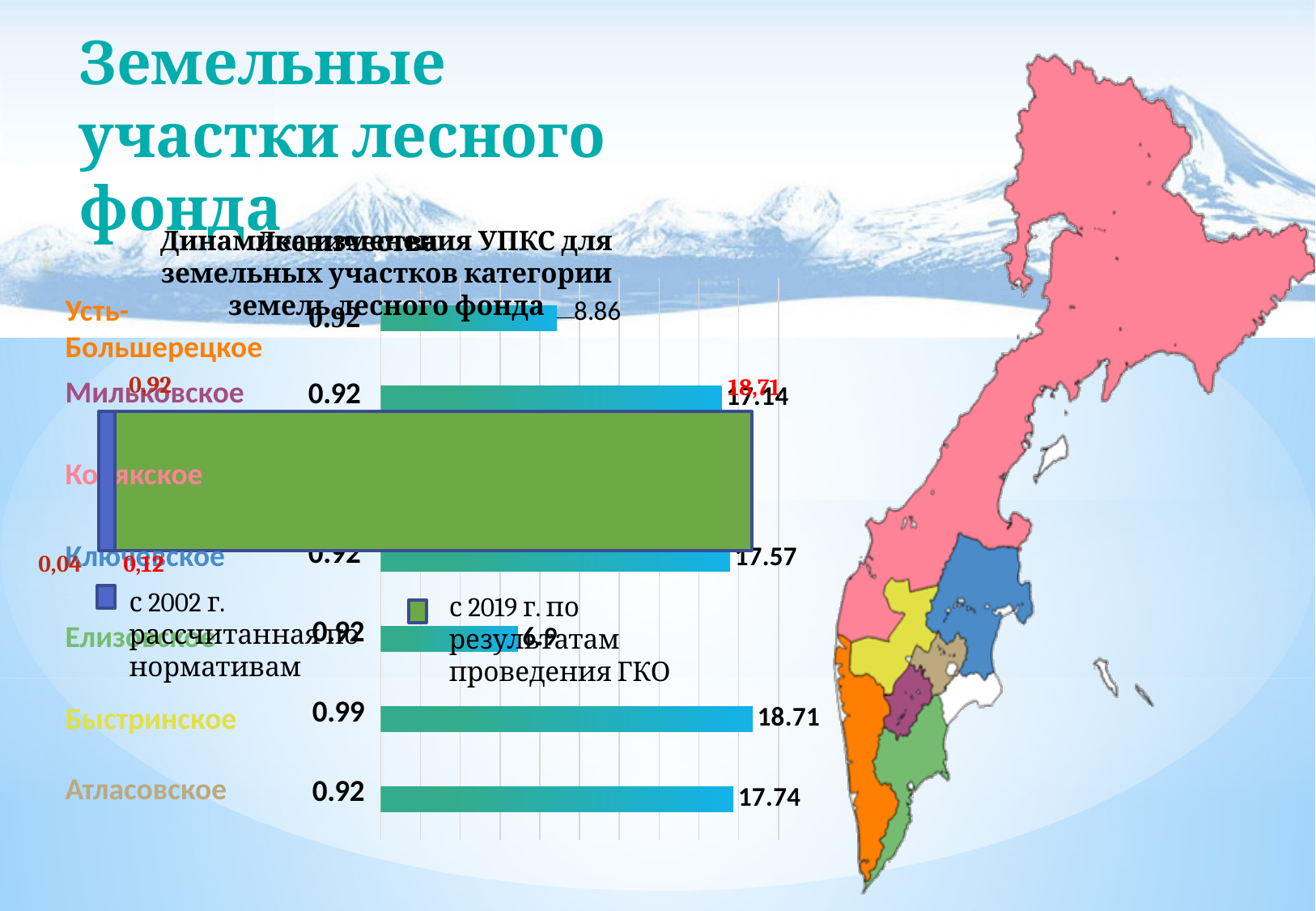
Among the districts with a labelled 2019 value, which has the highest value in the 'с 2019 г.' series? Быстринское Among the districts with a labelled 2019 value, which has the lowest value in the 'с 2019 г.' series? Елизовское How much larger is the 2019 value for Быстринское than the 2019 value for Атласовское? 0.97 What is the value for Атласовское in the 'с 2019 г. по результатам проведения ГКО' series? 17.74 What is the value for Елизовское in the 'с 2019 г. по результатам проведения ГКО' series? 6.9 Which has the larger 2019 value, Ключевское or Мильковское? Ключевское What is the difference between the 2019 value and the 2002 value for Атласовское? 16.82 How many series does the chart legend list? 2 What is the value for Быстринское in the 'с 2019 г. по результатам проведения ГКО' series? 18.71 What kind of chart is shown on the slide? Bar chart What is the value for Усть-Большерецкое in the 'с 2019 г. по результатам проведения ГКО' series? 8.86 What is the value for Быстринское in the 'с 2002 г. рассчитанная по нормативам' series? 0.99